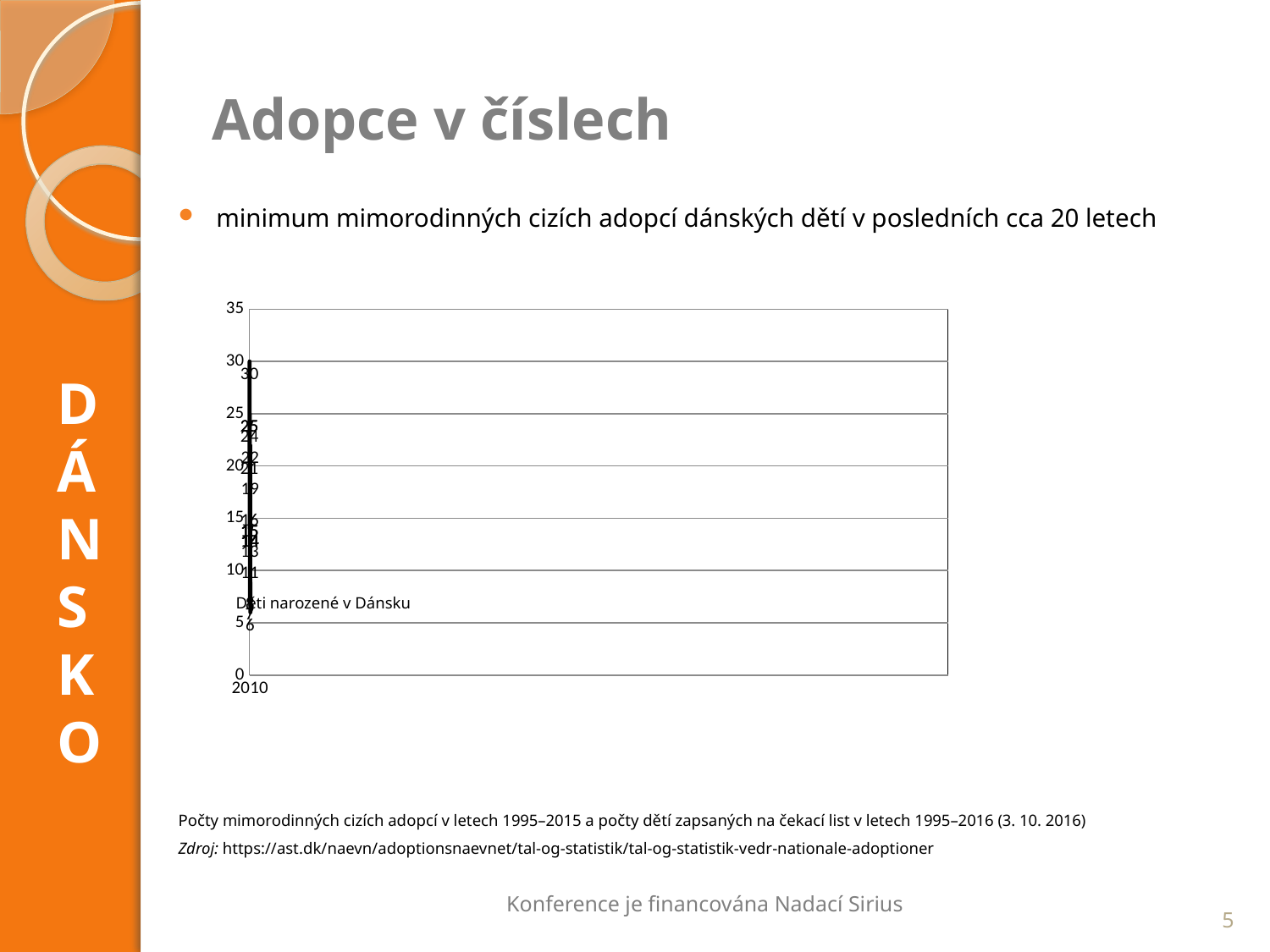
What is the only year label shown on the horizontal axis of the chart? 2010 What is the highest data label printed on the chart? 30 What is the highest value shown on the vertical axis of the chart? 35 Is the lowest plotted value in the chart greater or less than 10? less Is the highest plotted value in the chart greater or less than 25? greater